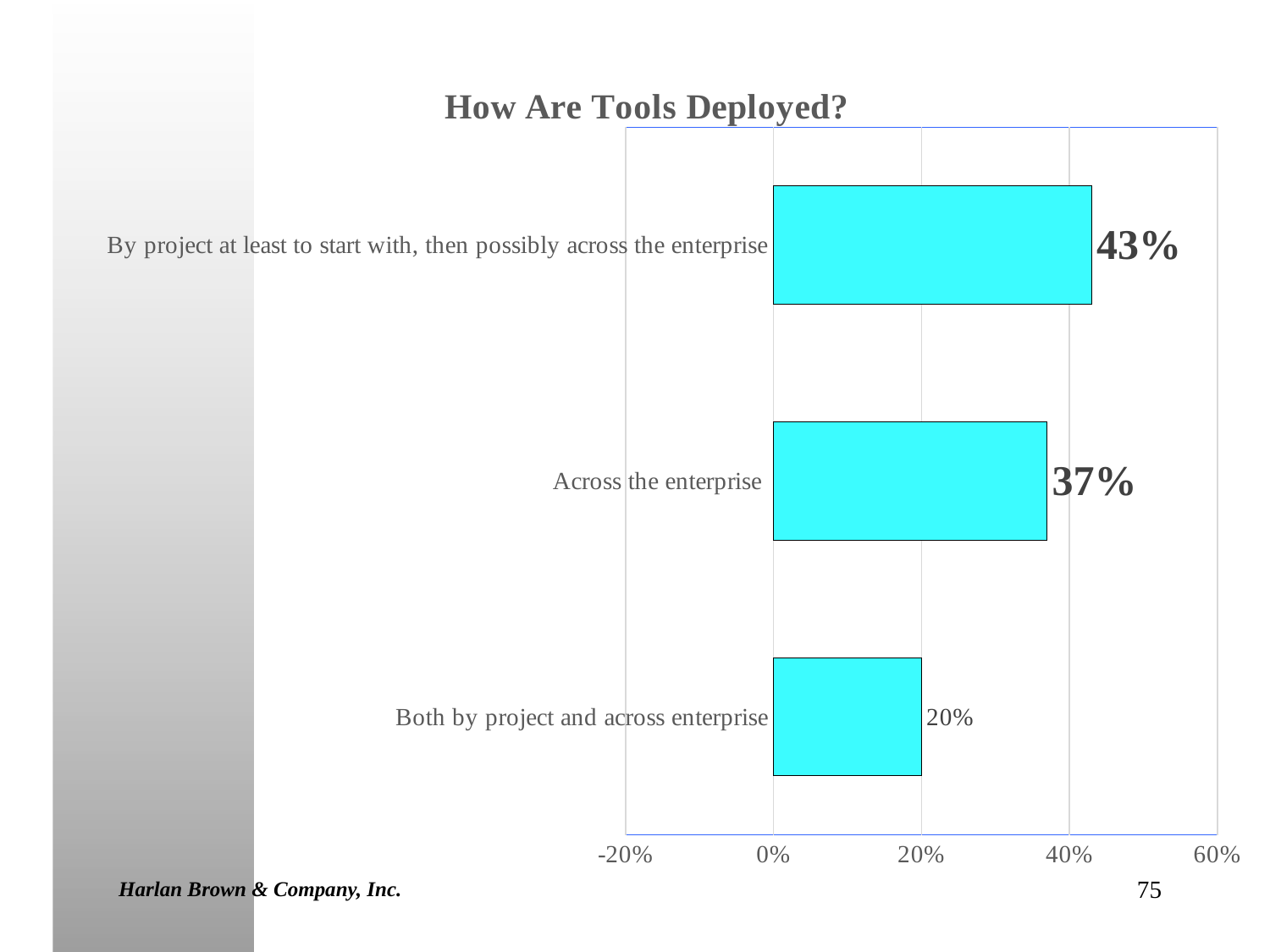
Which category has the lowest value? Both by project and across enterprise How many categories are shown in the chart? 3 What is the difference between the values for "Across the enterprise" and "Both by project and across enterprise"? 17% What is the value for "By project at least to start with, then possibly across the enterprise"? 43% What is the difference between the values for "By project at least to start with, then possibly across the enterprise" and "Across the enterprise"? 6% Which is larger: the value for "Across the enterprise" or the value for "Both by project and across enterprise"? Across the enterprise What is the value for "Both by project and across enterprise"? 20% Is the value for "Across the enterprise" greater or less than 40%? less What is the value for "Across the enterprise"? 37% What is the title of the chart? How Are Tools Deployed? Which category has the highest value? By project at least to start with, then possibly across the enterprise What kind of chart is shown on the slide? Bar chart